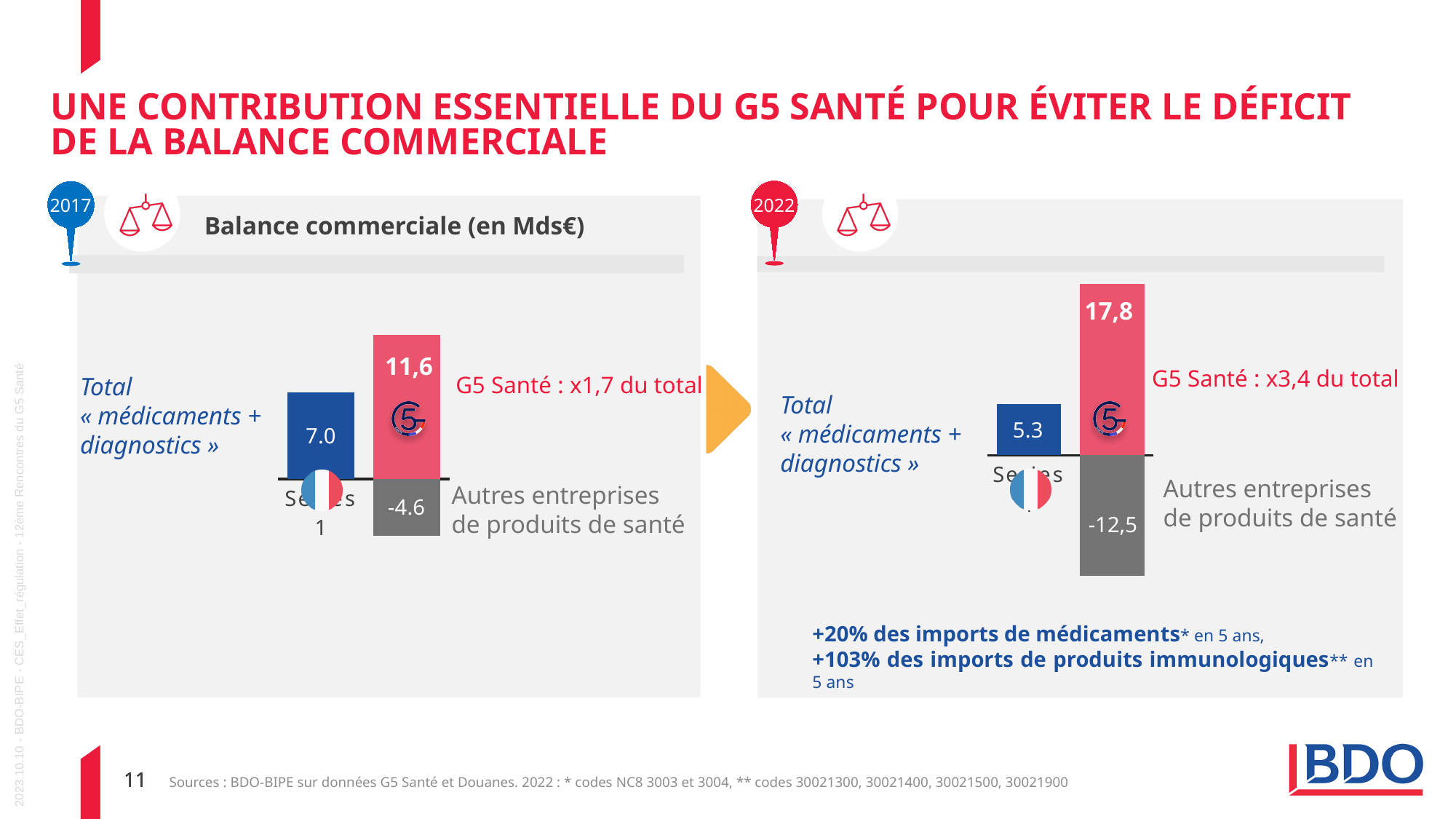
In the 2017 chart, which bar has the lowest value? Autres entreprises de produits de santé In the 2022 chart, what is the value for the G5 Santé bar? 17,8 According to the 2022 chart annotation, G5 Santé represents how many times the total? x3,4 Is the G5 Santé value larger in the 2017 chart or in the 2022 chart? 2022 In the 2017 chart, what is the value for Autres entreprises de produits de santé? -4.6 In the 2022 chart, what is the difference between the G5 Santé value and the Autres entreprises de produits de santé value? 30,3 In the 2022 chart, what is the value for Autres entreprises de produits de santé? -12,5 In the 2022 chart, which bar has the highest value? G5 Santé In the 2017 chart, what is the difference between the Total « médicaments + diagnostics » value and the Autres entreprises de produits de santé value? 11.6 What kind of chart is used in the 2017 panel? Bar chart In the 2017 chart, what is the value for the G5 Santé bar? 11,6 In the 2017 chart, what is the value for the Total « médicaments + diagnostics » bar? 7.0